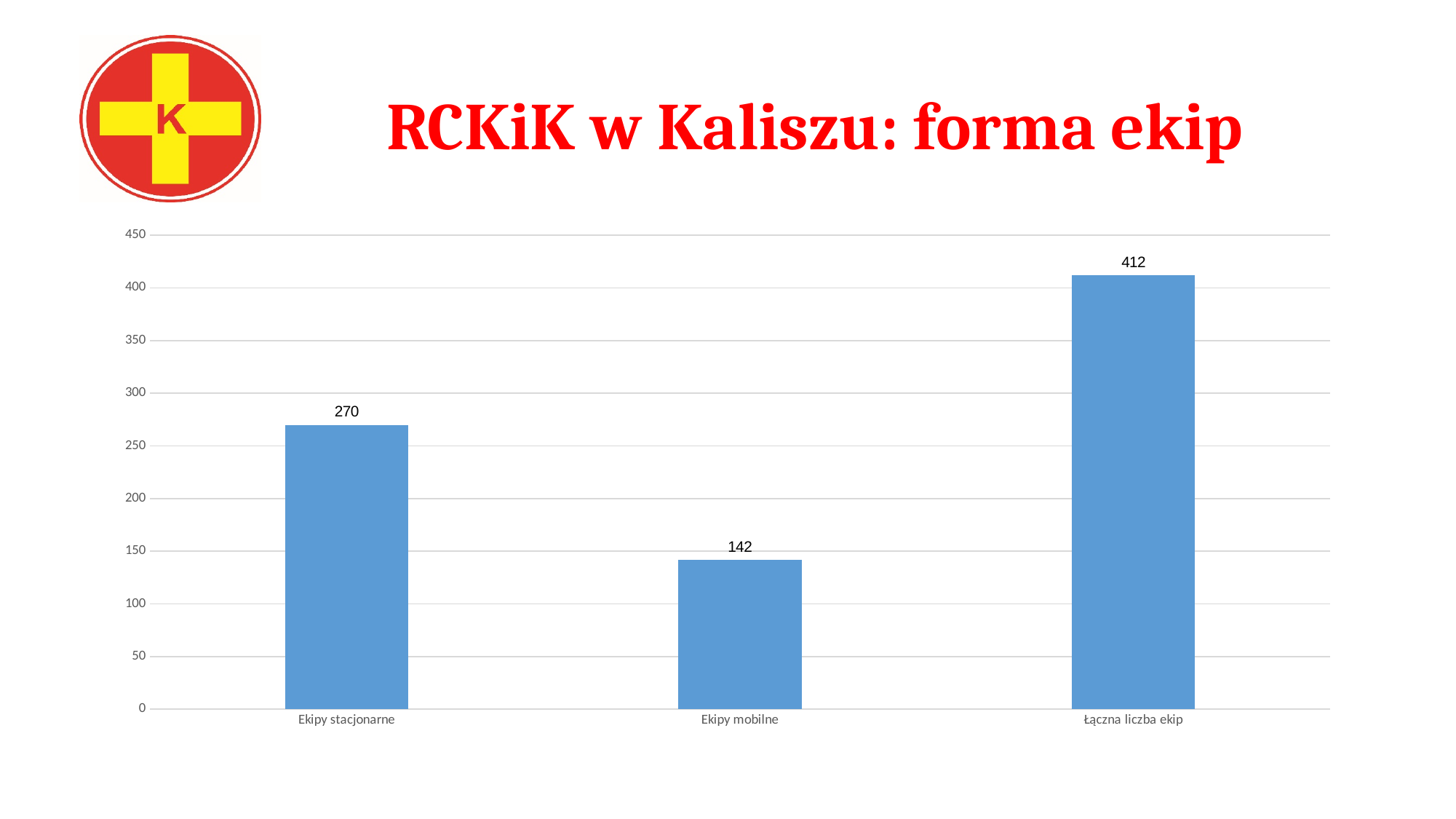
How many categories are shown on the x axis? 3 What kind of chart is shown on the slide? bar chart Is the value for Łączna liczba ekip greater or less than 400? greater Which is larger, the value for Ekipy stacjonarne or the value for Ekipy mobilne? Ekipy stacjonarne What is the value for Ekipy stacjonarne? 270 Which category has the highest value? Łączna liczba ekip What is the value for Ekipy mobilne? 142 What is the difference between the values for Ekipy stacjonarne and Ekipy mobilne? 128 Which category has the lowest value? Ekipy mobilne What is the title of the slide? RCKiK w Kaliszu: forma ekip What is the difference between the values for Łączna liczba ekip and Ekipy stacjonarne? 142 What is the value for Łączna liczba ekip? 412